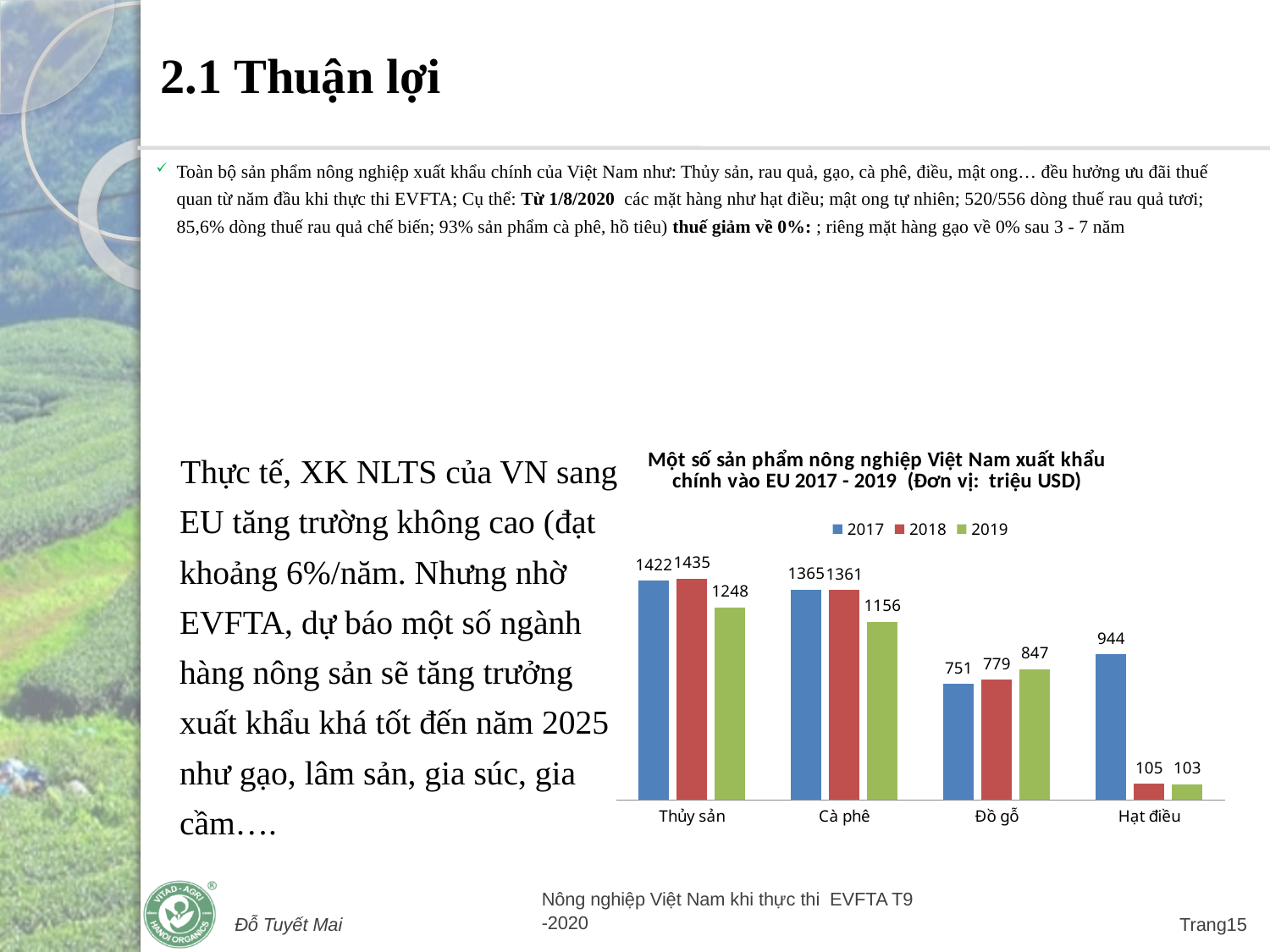
What was the export value of Hạt điều in 2017? 944 Which category had the highest export value in 2017? Thủy sản What is the difference between the 2019 and 2017 export values for Đồ gỗ? 96 How many product categories are shown on the x axis? 4 How many series does the legend list? 3 Which category had the lowest export value in 2019? Hạt điều What type of chart is shown on the slide? Bar chart What was the export value of Cà phê in 2019? 1156 Which is larger: the 2018 value for Cà phê or the 2018 value for Đồ gỗ? Cà phê What was the export value of Thủy sản in 2018? 1435 What was the export value of Đồ gỗ in 2017? 751 What is the difference between the 2017 and 2019 export values for Thủy sản? 174